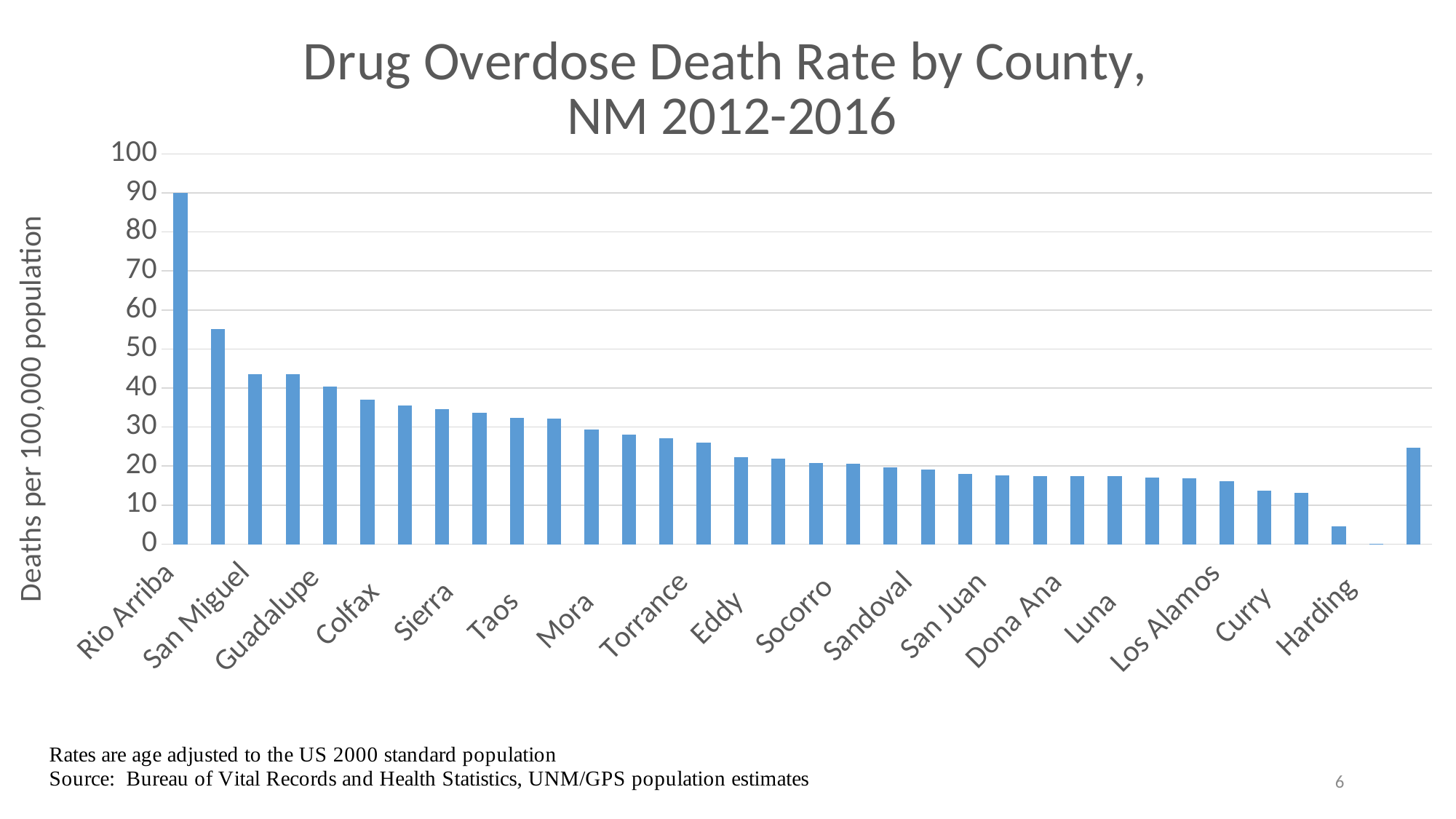
Is the value for Eddy greater or less than 30? less What is the title of the chart? Drug Overdose Death Rate by County, NM 2012-2016 Is the value for San Miguel greater or less than 40? greater Is the value for Colfax greater or less than 40? less What is the label on the vertical axis? Deaths per 100,000 population What type of chart is shown on the slide? bar chart Do the county death rates generally rise or fall moving from left to right across the labeled counties? fall Which county has the highest drug overdose death rate? Rio Arriba Which has a higher death rate, Rio Arriba or San Miguel? Rio Arriba Which labeled county has the lowest drug overdose death rate? Harding